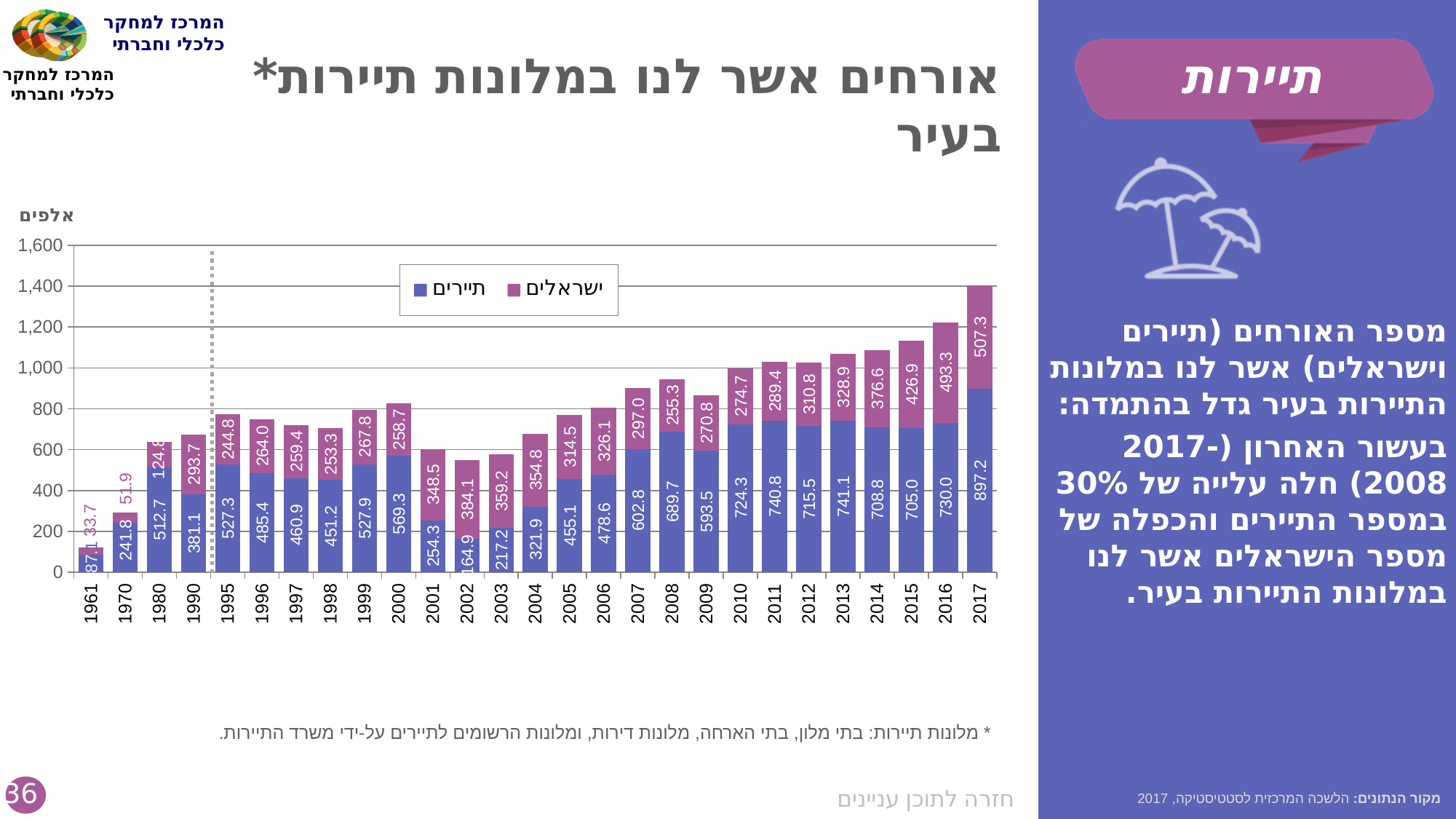
In which year is the תיירים (tourists) value the highest? 2017 Is the total of the stacked bar for 2016 greater or less than 1,200? greater How many series does the legend list? 2 What kind of chart is shown on the slide? Stacked bar chart How many years are shown on the x axis? 27 What is the value for תיירים (tourists) in 2017? 897.2 In which year is the תיירים (tourists) value the lowest? 1961 What is the difference between the ישראלים (Israelis) values for 2017 and 2016? 14.0 In 2004, which is larger: the תיירים (tourists) value or the ישראלים (Israelis) value? ישראלים (Israelis) What is the value for תיירים (tourists) in 2002? 164.9 What is the total of the stacked bar for 2017? 1,404.5 What is the value for ישראלים (Israelis) in 2017? 507.3